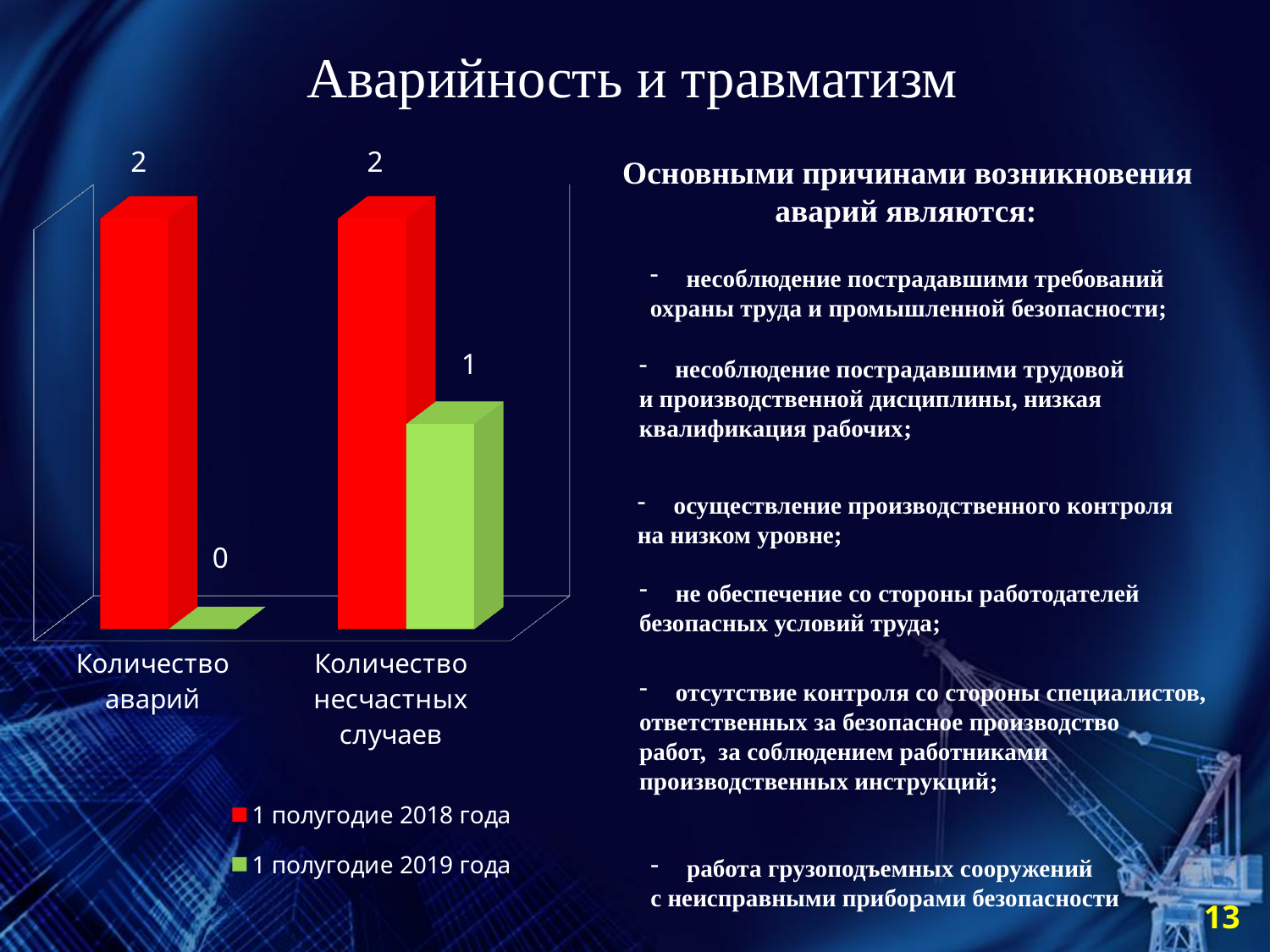
What is the difference between the 2018 and 2019 values for "Количество несчастных случаев"? 1 What kind of chart is shown on the slide? Bar chart How many series does the legend list? 2 In the series "1 полугодие 2019 года", which category has the lowest value? Количество аварий What is the value for "Количество несчастных случаев" in the series "1 полугодие 2019 года"? 1 What is the difference between the 2018 and 2019 values for "Количество аварий"? 2 What is the value for "Количество аварий" in the series "1 полугодие 2018 года"? 2 In the series "1 полугодие 2019 года", which category has the highest value? Количество несчастных случаев Which is larger for "Количество несчастных случаев": the value for 1 полугодие 2018 года or for 1 полугодие 2019 года? 1 полугодие 2018 года What is the value for "Количество аварий" in the series "1 полугодие 2019 года"? 0 What is the value for "Количество несчастных случаев" in the series "1 полугодие 2018 года"? 2 How many categories are shown on the chart? 2